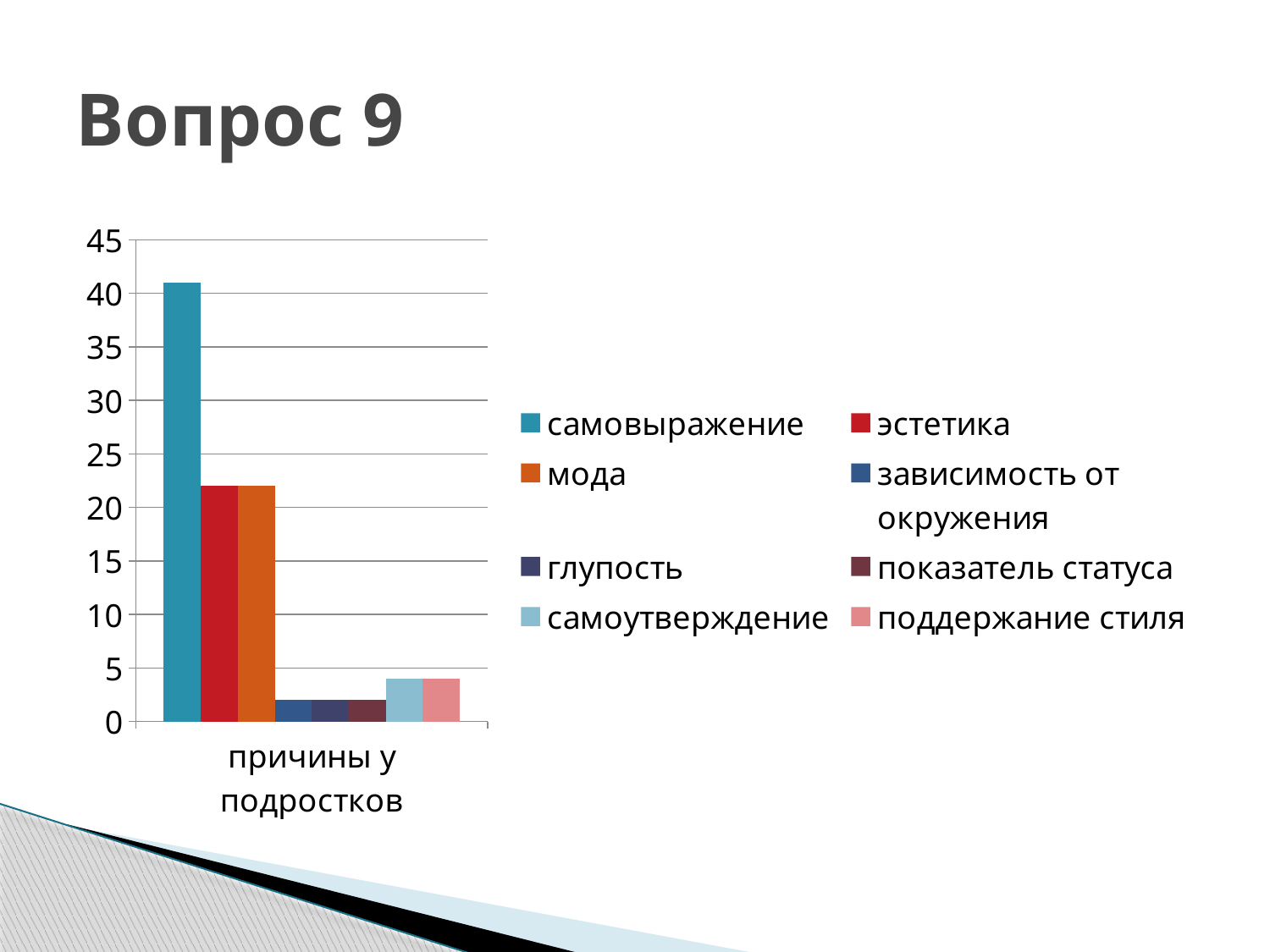
Which is larger, the value for самовыражение or the value for эстетика? самовыражение How many categories are shown on the x axis? 1 Is the value for самоутверждение greater or less than 5? less Is the value for мода greater or less than 15? greater Which is larger, the value for самоутверждение or the value for показатель статуса? самоутверждение Is the value for глупость greater or less than 5? less Which series has the highest value? самовыражение How many series does the legend list? 8 What kind of chart is shown on the slide? bar chart What is the label of the category on the x axis? причины у подростков